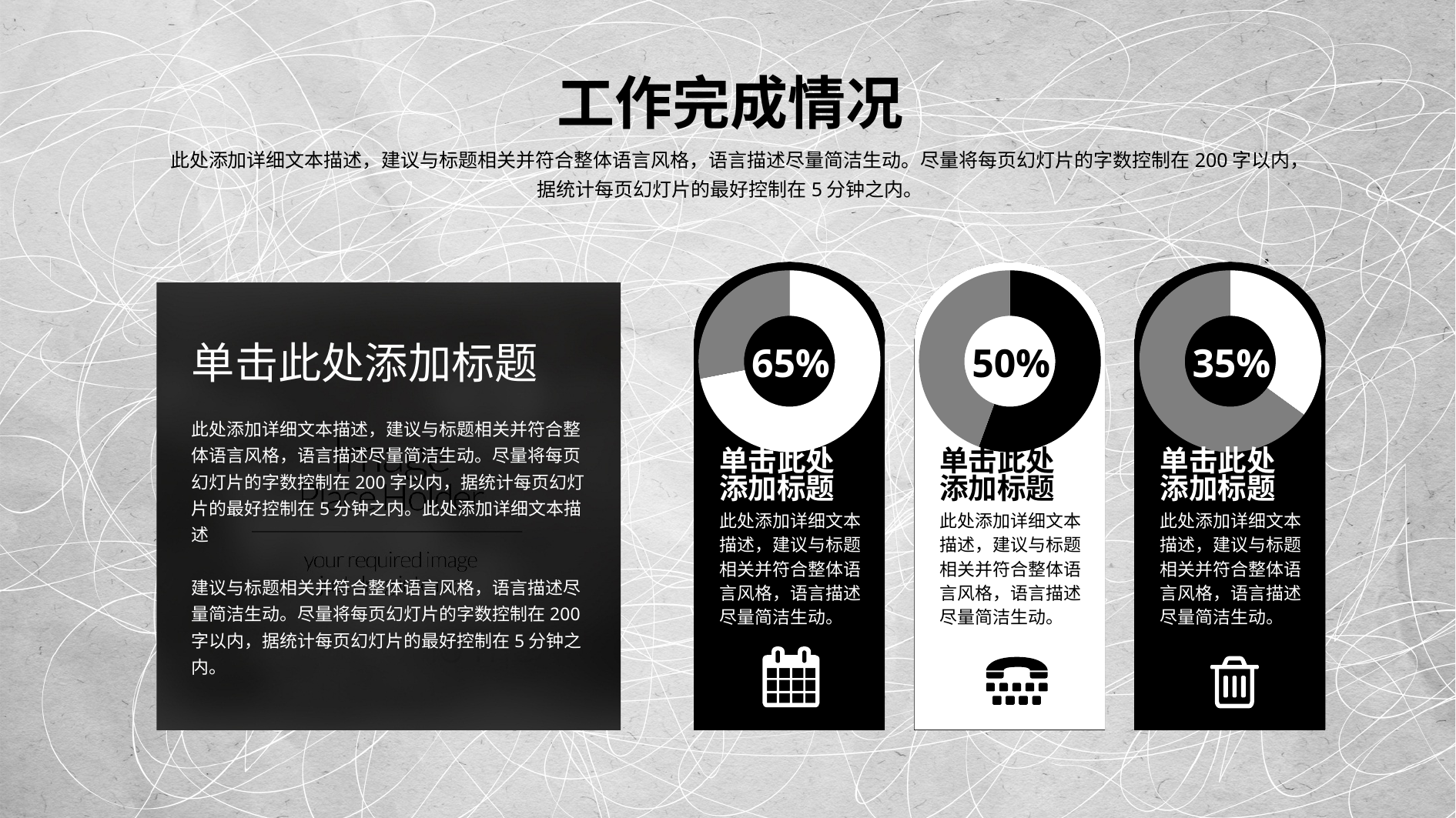
Which of the three donut charts shows the lowest percentage? The right one (35%) What is the difference between the percentage in the left donut chart and the percentage in the right donut chart? 30% How many donut charts are on the slide? 3 What value is shown in the centre of the middle donut chart? 50% What value is shown in the centre of the left donut chart? 65% What kind of chart is used to show the percentages on this slide? Donut (pie) chart Which is larger, the percentage in the middle donut chart or the percentage in the right donut chart? The middle donut chart (50%) How many slices does each donut chart have? 2 Which of the three donut charts shows the highest percentage? The left one (65%) What is the title of the slide containing the donut charts? 工作完成情况 What is the difference between the percentage in the left donut chart and the percentage in the middle donut chart? 15% What value is shown in the centre of the right donut chart? 35%